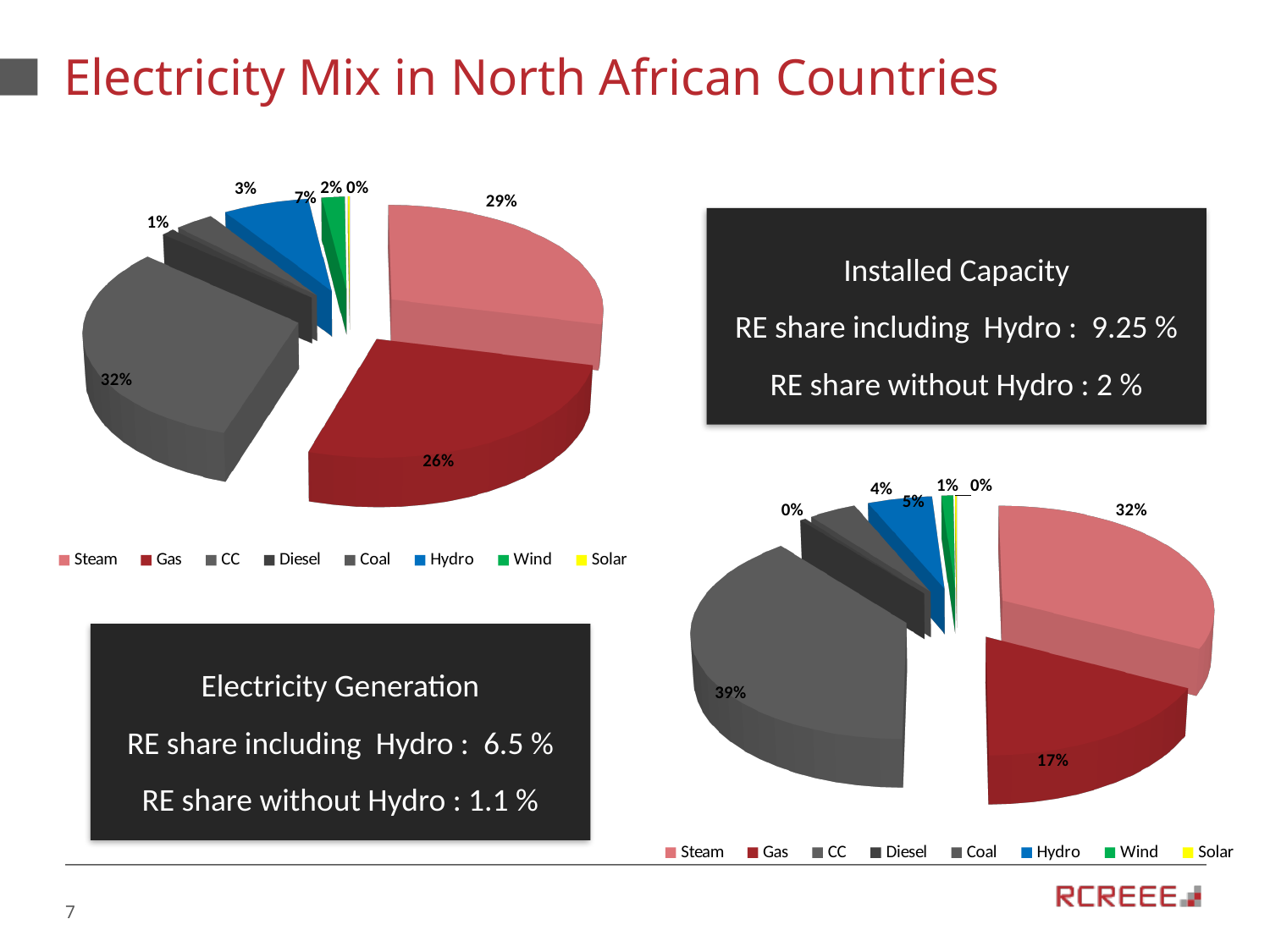
In the top-left pie chart, what share does Gas have? 26% In the bottom-right pie chart, which category has the largest share? CC What type of charts are shown on the slide? Pie charts In the bottom-right pie chart, what share does Hydro have? 5% In the bottom-right pie chart, what share does Gas have? 17% In the top-left pie chart, what share does Steam have? 29% In the top-left pie chart, what is the difference between the CC share and the Gas share? 6% How many categories does the legend of the top-left pie chart list? 8 In the bottom-right pie chart, which is larger, the Steam share or the Gas share? Steam In the top-left pie chart, which category has the largest share? CC In the top-left pie chart, what share does Hydro have? 7% In the bottom-right pie chart, what share does Steam have? 32%